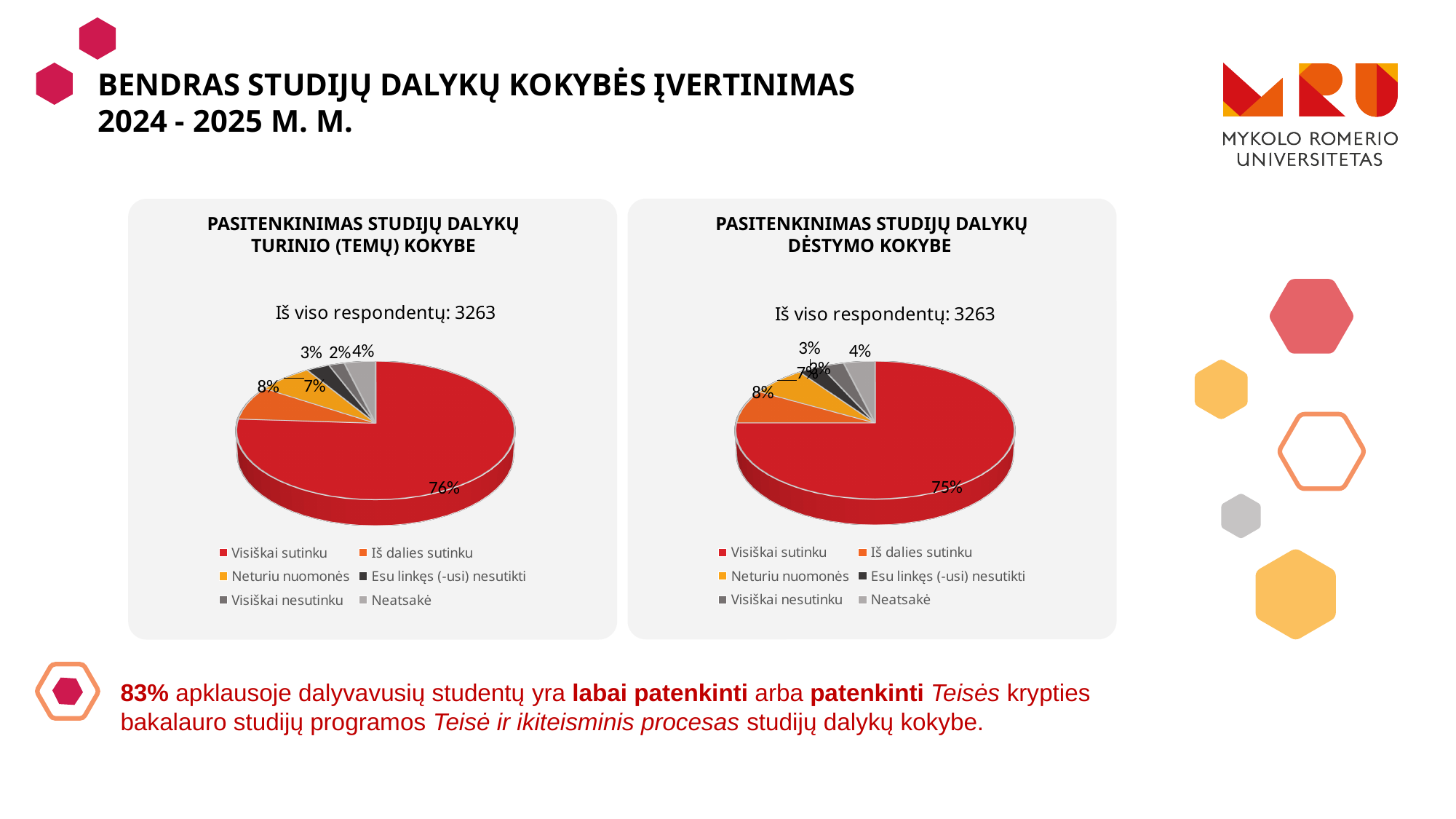
In the right chart (Pasitenkinimas studijų dalykų dėstymo kokybe), what share of respondents chose 'Neatsakė'? 4% In the right chart (Pasitenkinimas studijų dalykų dėstymo kokybe), what share of respondents chose 'Visiškai sutinku'? 75% In the left chart (Pasitenkinimas studijų dalykų turinio (temų) kokybe), which category has the smallest slice? Visiškai nesutinku How many respondents in total are reported for the left chart (Pasitenkinimas studijų dalykų turinio (temų) kokybe)? 3263 Which chart has the larger 'Visiškai sutinku' share, the left one (turinio kokybe) or the right one (dėstymo kokybe)? The left one (turinio kokybe) In the left chart (Pasitenkinimas studijų dalykų turinio (temų) kokybe), what share of respondents chose 'Neatsakė'? 4% In the left chart (Pasitenkinimas studijų dalykų turinio (temų) kokybe), what share of respondents chose 'Visiškai sutinku'? 76% In the left chart (Pasitenkinimas studijų dalykų turinio (temų) kokybe), what share of respondents chose 'Iš dalies sutinku'? 8% What type of chart is used on this slide? Pie chart In the left chart (Pasitenkinimas studijų dalykų turinio (temų) kokybe), which category has the largest slice? Visiškai sutinku In the left chart (Pasitenkinimas studijų dalykų turinio (temų) kokybe), what is the difference between the 'Visiškai sutinku' and 'Iš dalies sutinku' shares? 68 percentage points How many categories does the legend of the right chart (Pasitenkinimas studijų dalykų dėstymo kokybe) list? 6